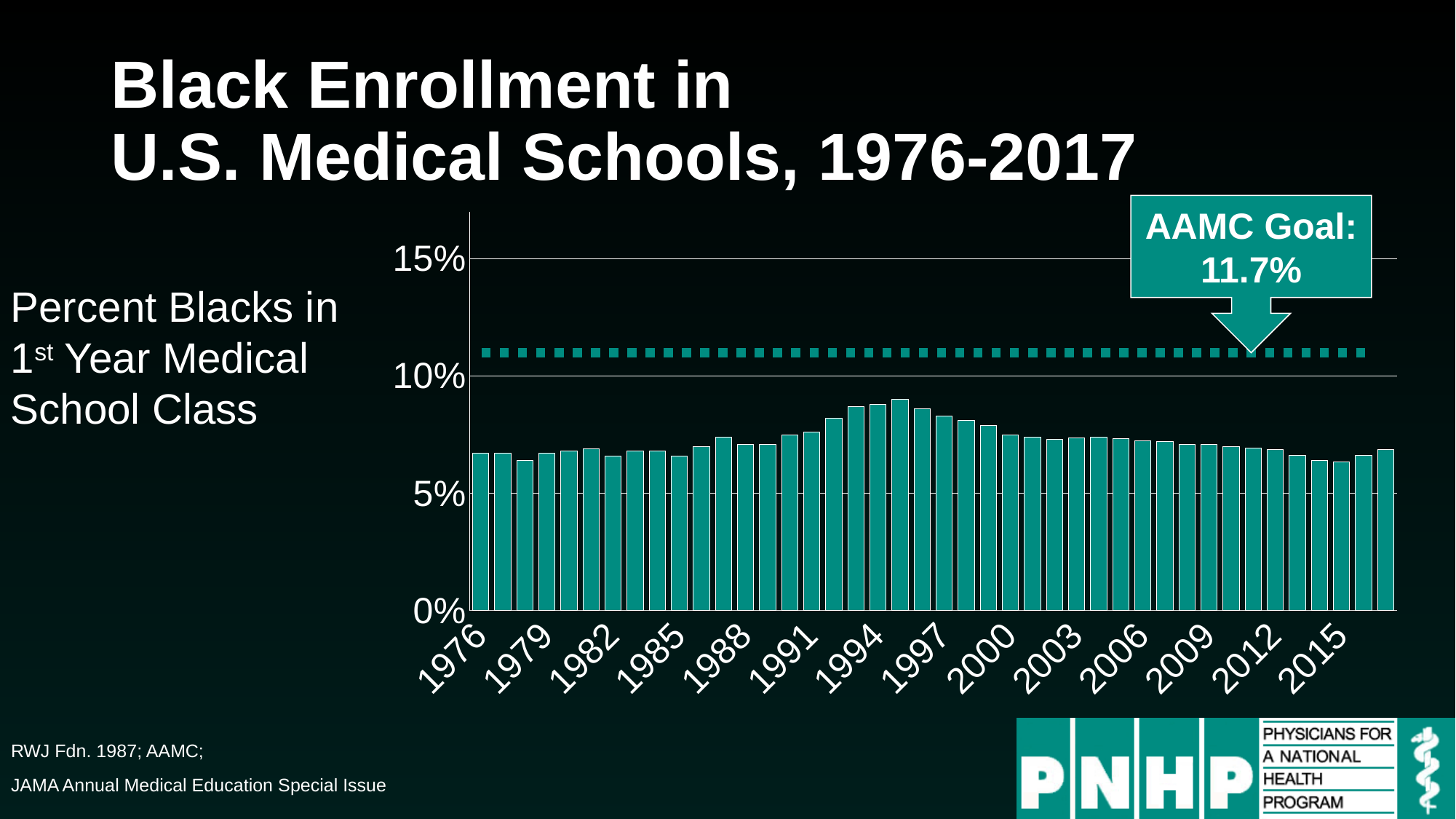
What is the AAMC goal shown on the chart? 11.7% Do the values rise or fall from 1994 to 2015? fall Which is larger, the value for 2014 or the value for 1993? 1993 Is the value for 2015 greater or less than 10%? less Does any year's bar reach the AAMC goal line of 11.7%? No Which is larger, the value for 1994 or the value for 1976? 1994 Do the values rise or fall from 1985 to 1994? rise Is the value for 1976 greater or less than 5%? greater What kind of chart is shown on the slide? bar chart What does the chart measure, according to the label to the left of it? Percent Blacks in 1st Year Medical School Class How many years (bars) are plotted on the chart? 42